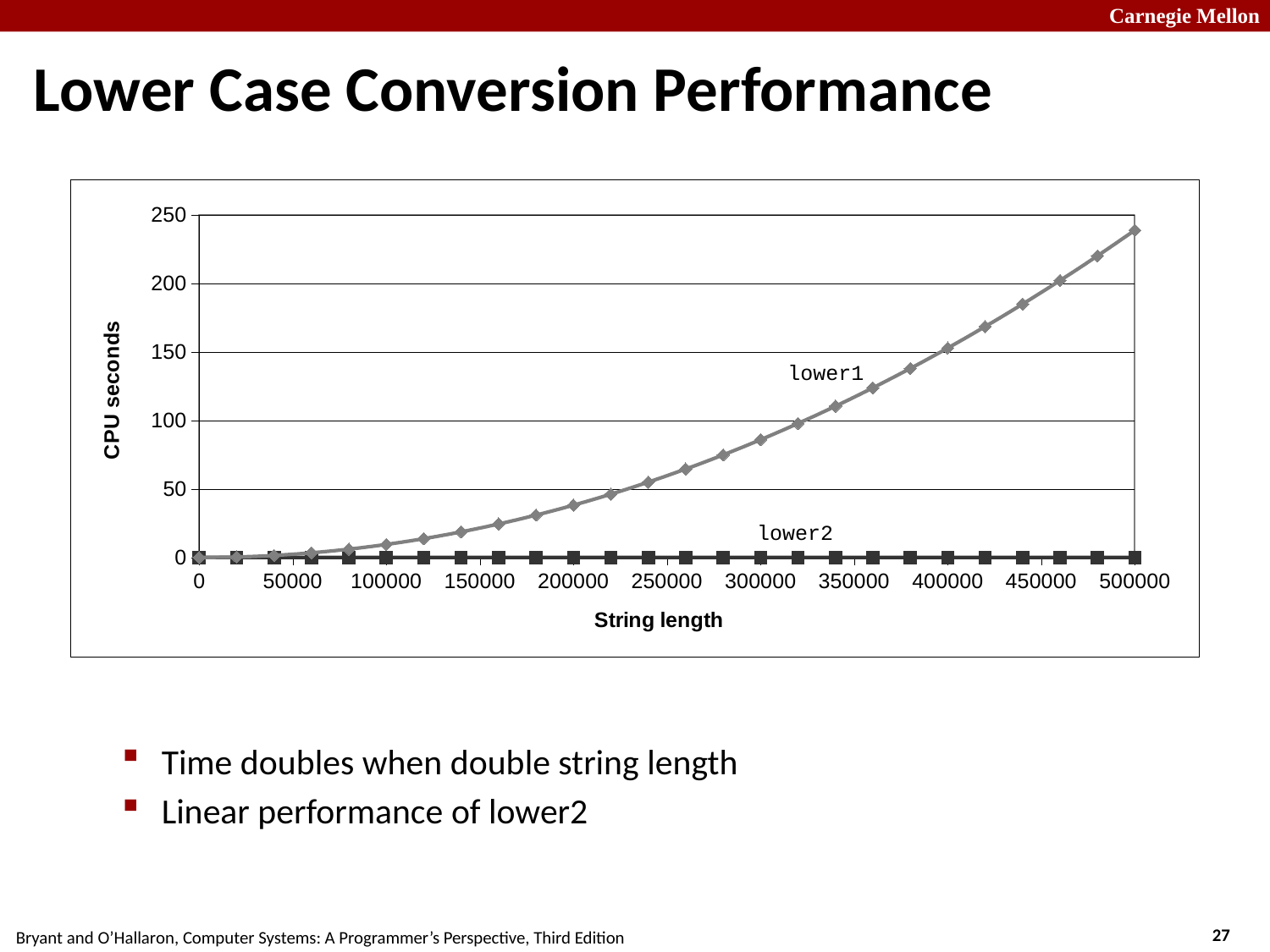
Which series stays lowest in CPU seconds across all string lengths? lower2 Which series has the higher CPU seconds at a string length of 500000, lower1 or lower2? lower1 Is the CPU seconds value for lower1 at a string length of 500000 greater or less than 200? greater Is the CPU seconds value for lower1 at a string length of 250000 greater or less than 100? less What is the title of the chart's x axis? String length Which series reaches the highest CPU seconds on the chart? lower1 How many data series are plotted on the chart? 2 What kind of chart is shown on the slide? line chart What is the title of the chart's y axis? CPU seconds Does the CPU time for lower1 rise or fall as string length increases? rise Is the CPU seconds value for lower1 at a string length of 300000 greater or less than 100? less